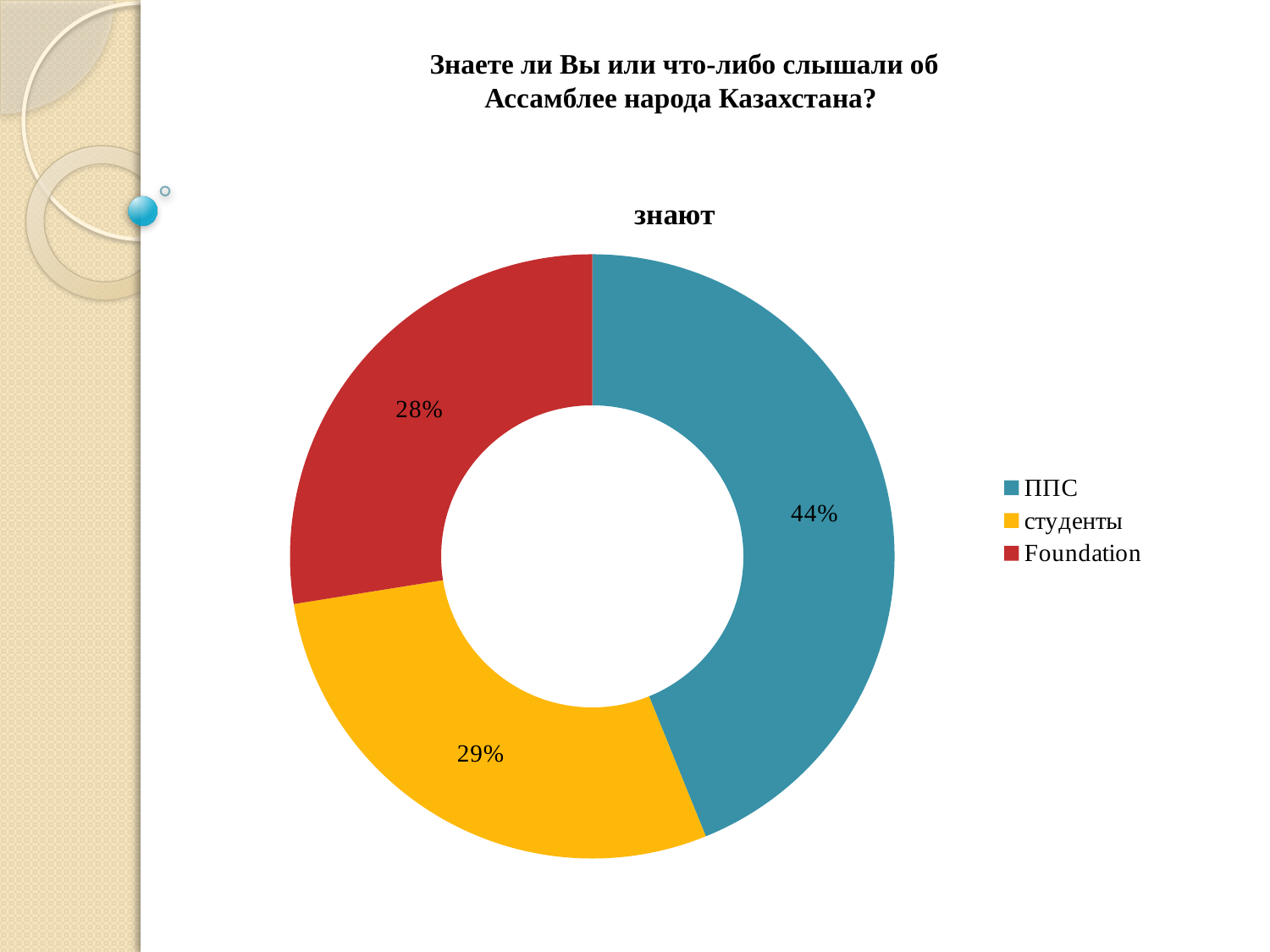
What is the title of the chart? знают Which is larger, the share for ППС or the share for Foundation? ППС What is the difference in percentage points between студенты and Foundation? 1 How many categories are shown in the chart? 3 How many entries does the legend list? 3 What is the difference in percentage points between ППС and студенты? 15 What percentage is shown for Foundation? 28% What kind of chart is shown on the slide? doughnut chart What percentage is shown for студенты? 29% Which category has the smallest share of the chart? Foundation Which category has the largest share of the chart? ППС What percentage of the doughnut chart is labelled for ППС? 44%